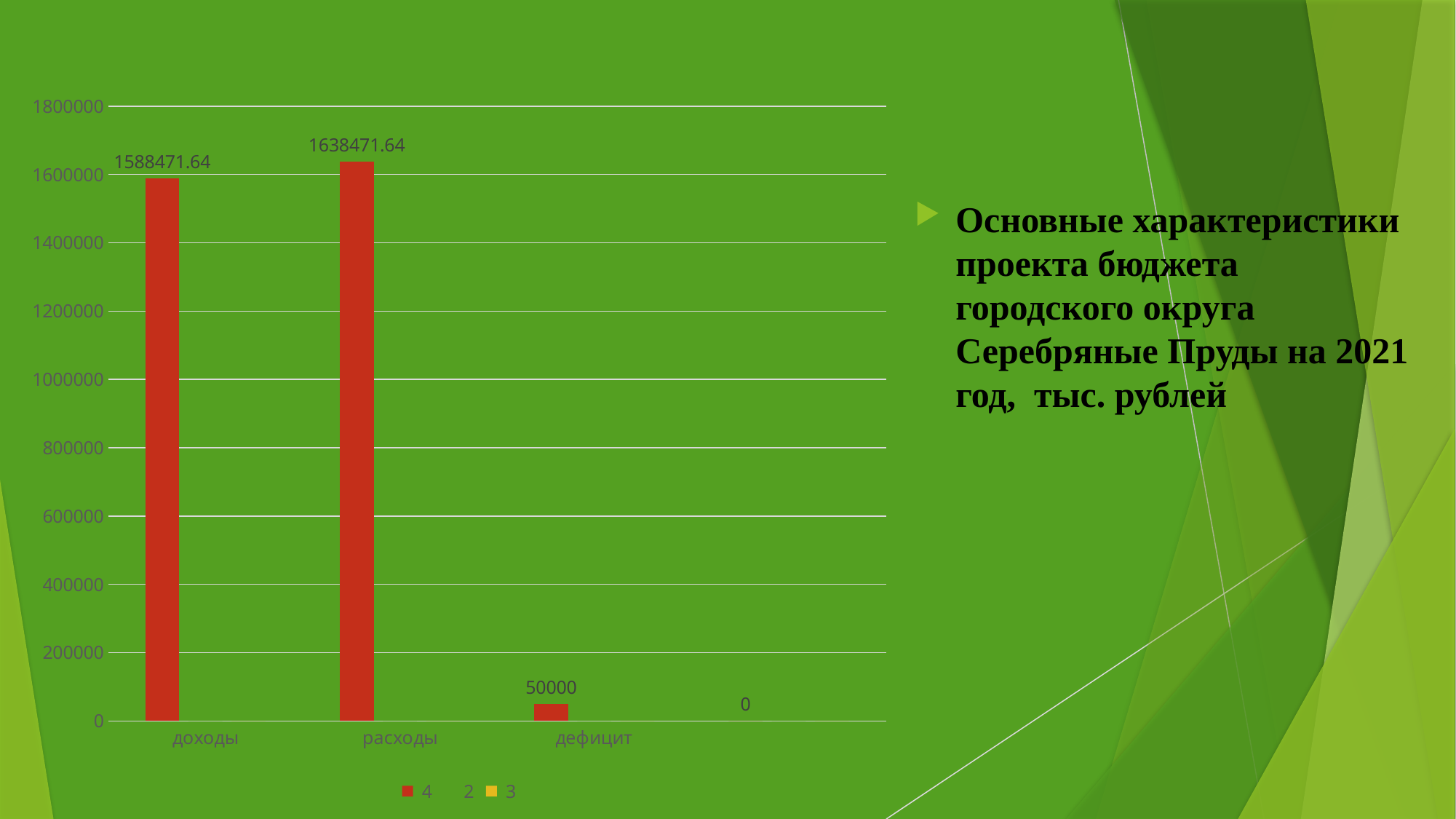
Which category has the highest value? расходы What is the value of the доходы bar? 1588471.64 Is the value for дефицит greater or less than 200000? less What is the value of the дефицит bar? 50000 Which is larger, доходы or расходы? расходы What kind of chart is shown on the slide? bar chart Is the value for доходы greater or less than 1400000? greater What is the difference between the расходы and доходы values? 50000 How many series does the legend list? 3 Which of the labelled categories has the lowest value? дефицит What is the value of the расходы bar? 1638471.64 What colour are the bars in the chart? red